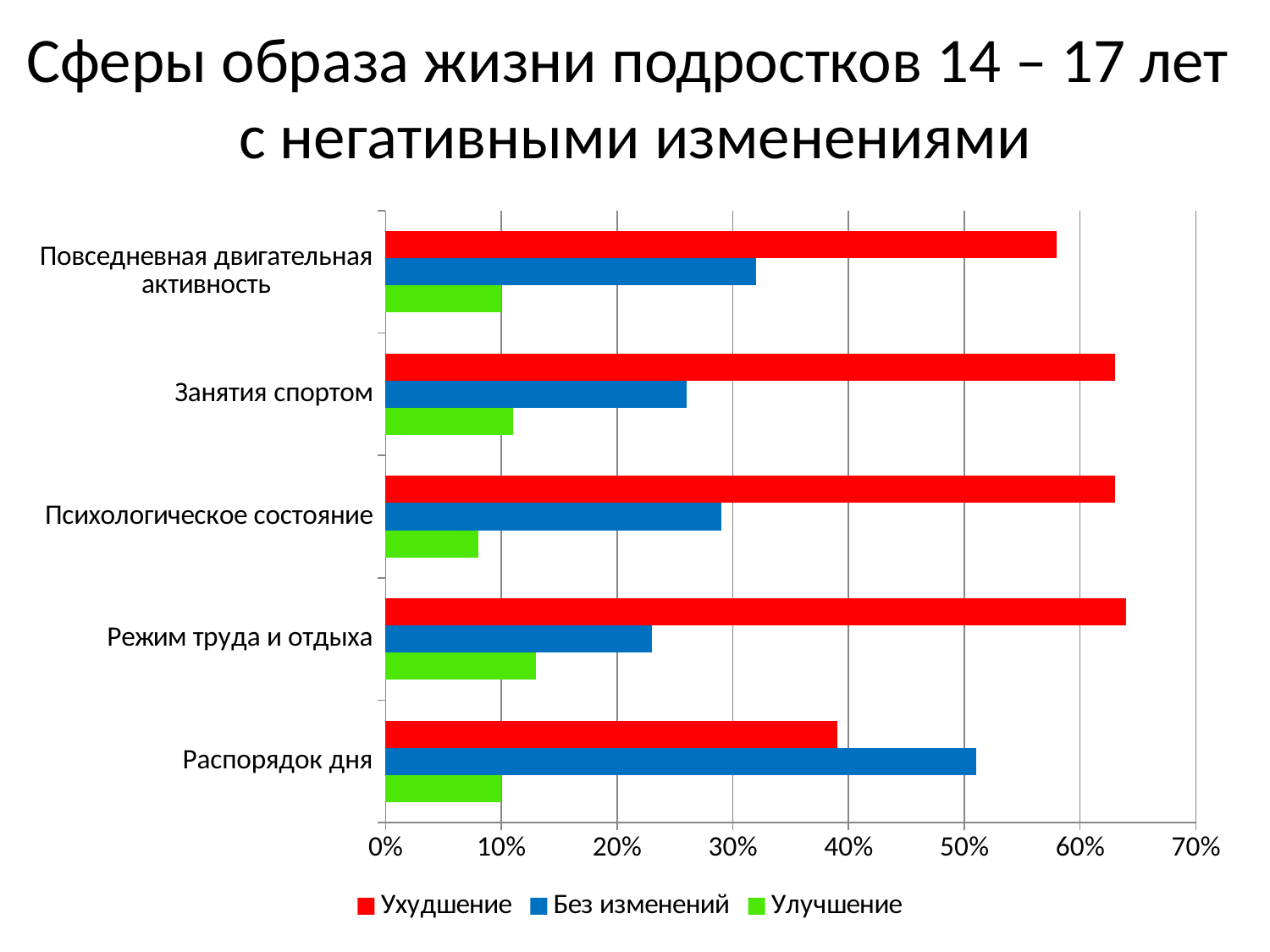
Is the Без изменений value for Занятия спортом greater or less than 30%? less For Распорядок дня, which is larger: Ухудшение or Без изменений? Без изменений Is the Ухудшение value for Повседневная двигательная активность greater or less than 50%? greater How many categories are shown on the chart? 5 For Повседневная двигательная активность, which is larger: Ухудшение or Без изменений? Ухудшение Is the Улучшение value for Режим труда и отдыха greater or less than 20%? less How many series does the legend list? 3 What kind of chart is shown on the slide? bar chart Which series is shown in green in the legend? Улучшение Which category has the lowest value for the Ухудшение series? Распорядок дня Which category has the highest value for the Без изменений series? Распорядок дня